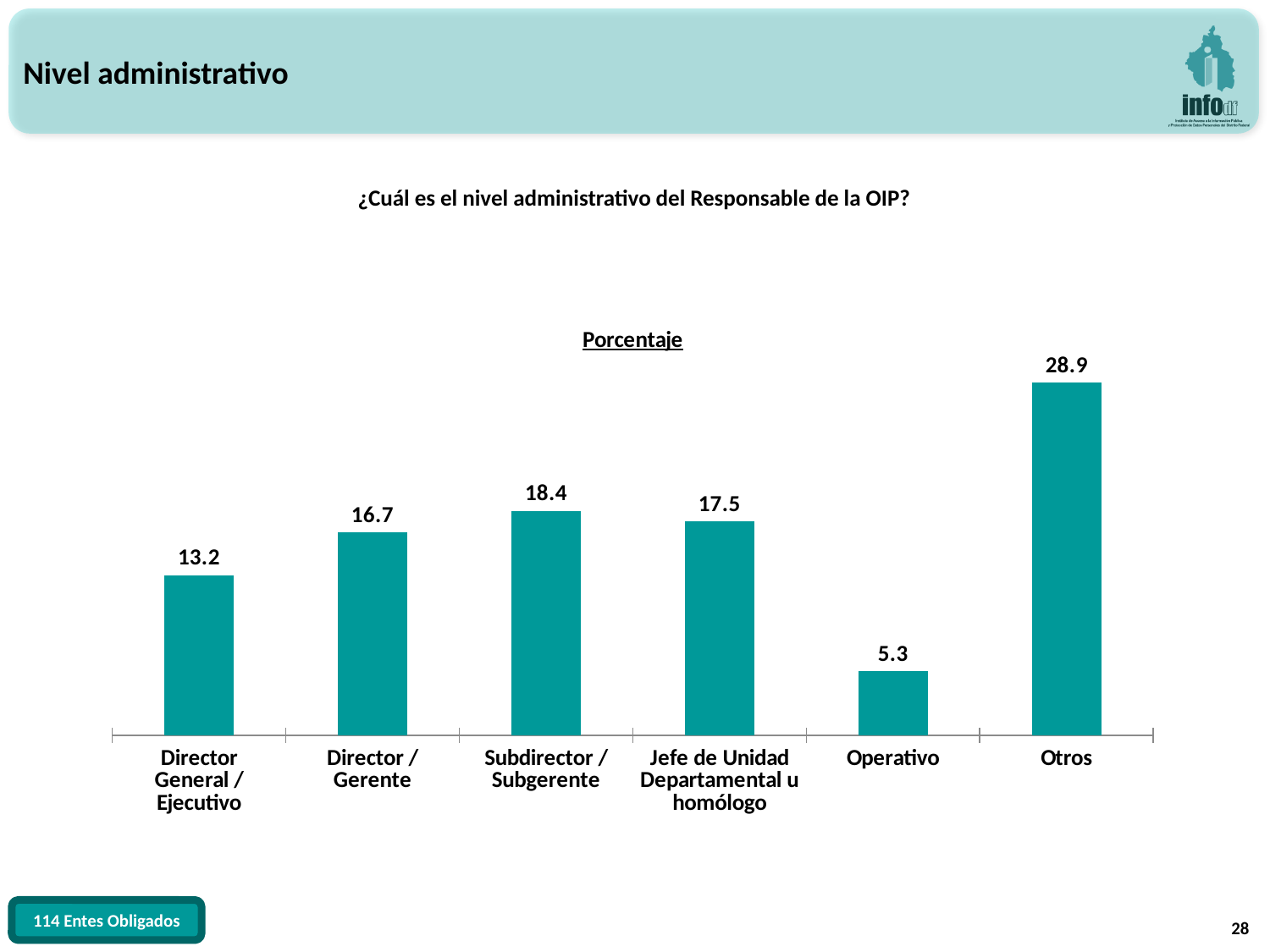
Which category has the highest value? Otros What is the difference between the values for Subdirector / Subgerente and Director / Gerente? 1.7 What is the value for Director General / Ejecutivo? 13.2 How many categories are shown in the chart? 6 Which is larger, the value for Jefe de Unidad Departamental u homólogo or the value for Director General / Ejecutivo? Jefe de Unidad Departamental u homólogo What is the title of the chart? Porcentaje What is the difference between the values for Otros and Operativo? 23.6 What kind of chart is shown on the slide? bar chart What is the value for Subdirector / Subgerente? 18.4 Which category has the lowest value? Operativo What is the value for Otros? 28.9 What is the value for Operativo? 5.3